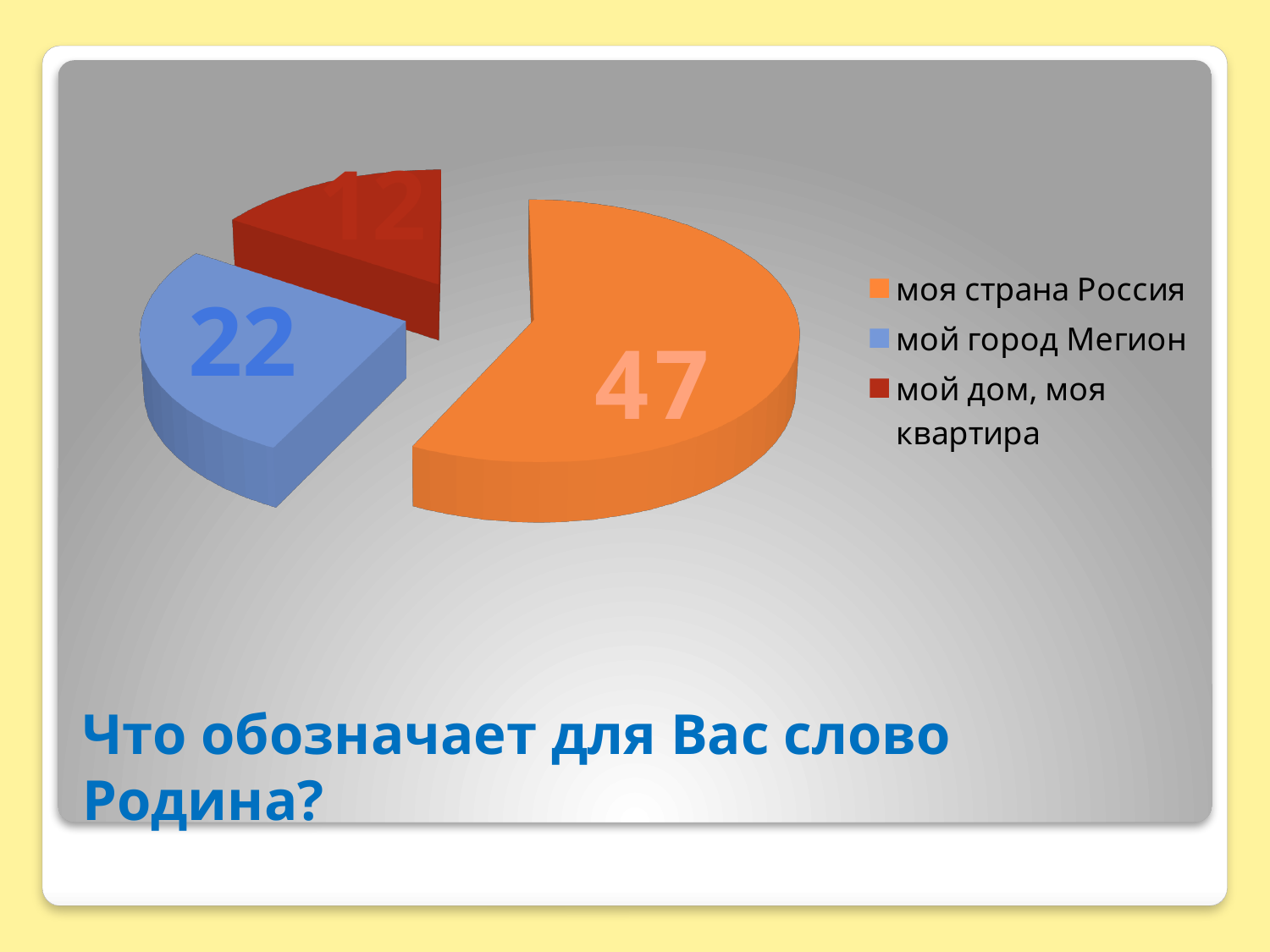
What is the value for "мой город Мегион"? 22 Which category has the largest slice of the pie? моя страна Россия What is the sum of all three values shown on the pie chart? 81 How many slices does the pie chart have? 3 What is the difference between the values for "моя страна Россия" and "мой город Мегион"? 25 What is the title of the chart? Что обозначает для Вас слово Родина? Which category has the smallest slice of the pie? мой дом, моя квартира What is the value for "мой дом, моя квартира"? 12 Which is larger, the value for "мой город Мегион" or the value for "мой дом, моя квартира"? мой город Мегион What is the difference between the values for "мой город Мегион" and "мой дом, моя квартира"? 10 What kind of chart is shown on the slide? pie chart What is the value for "моя страна Россия"? 47